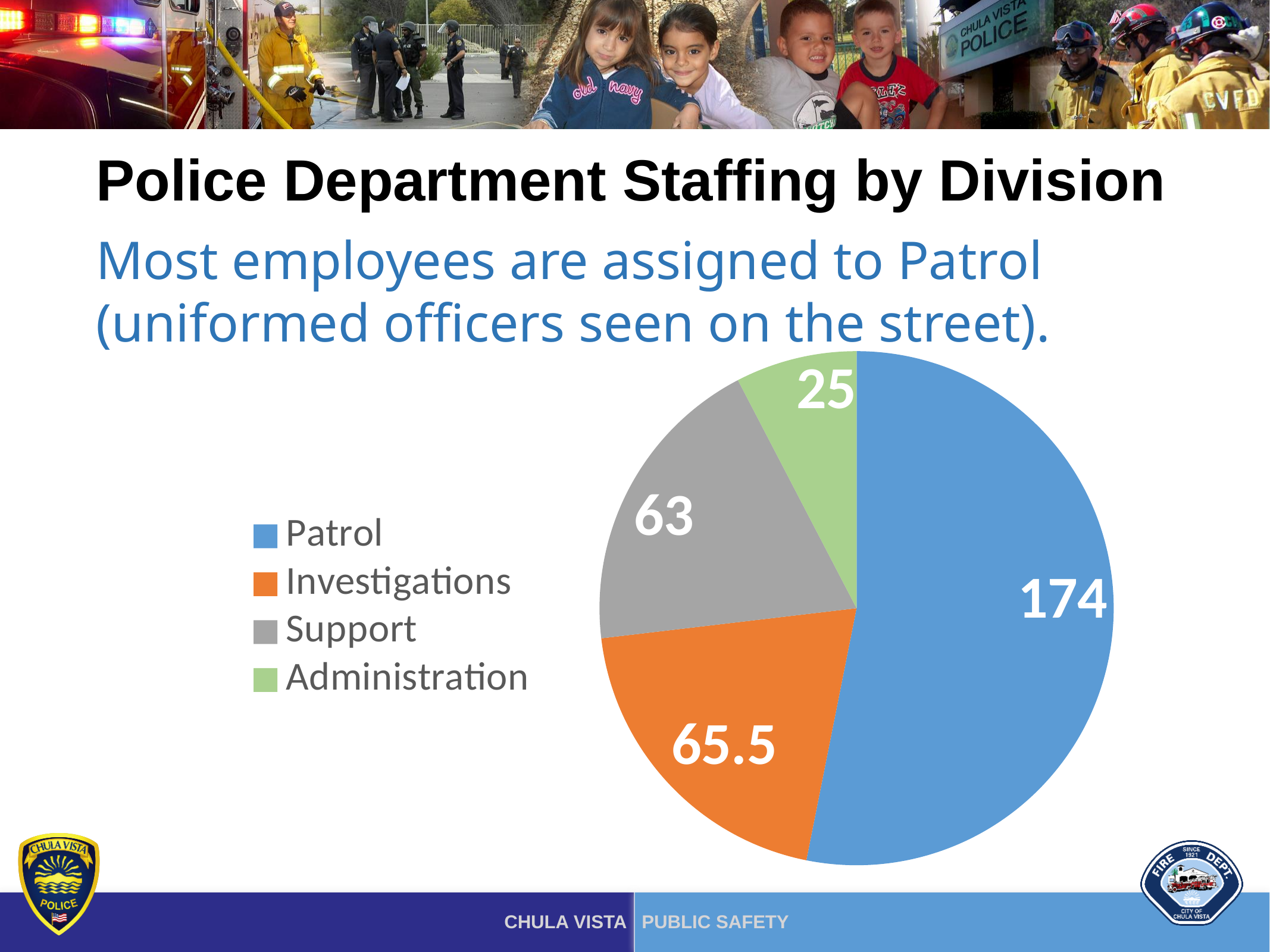
What is the value for Investigations? 65.5 Which is larger, the value for Investigations or the value for Support? Investigations Which division has the largest slice of the pie? Patrol What is the value for Support? 63 Which division has the smallest slice of the pie? Administration What is the value for Administration? 25 What type of chart is shown on the slide? pie chart How many staff are assigned to Patrol? 174 Which colour represents Support in the pie chart? gray How many divisions are shown in the pie chart? 4 What is the difference between the Patrol and Support values? 111 What is the total of all four slices in the pie chart? 327.5